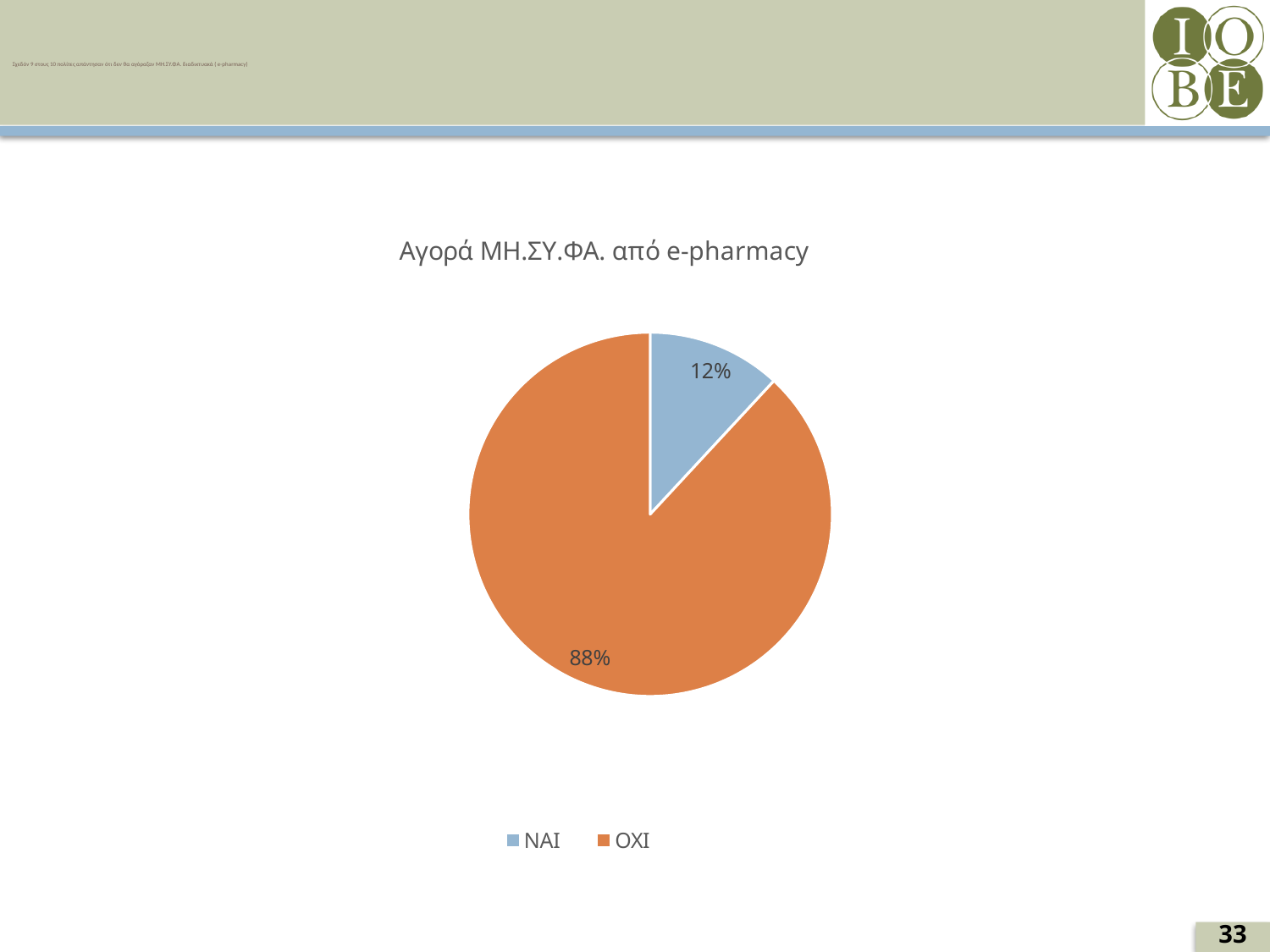
What is the title of the chart? Αγορά ΜΗ.ΣΥ.ΦΑ. από e-pharmacy What is the difference in percentage points between the ΟΧΙ and ΝΑΙ slices? 76 Which slice is the smallest? ΝΑΙ How many entries does the legend list? 2 How many slices does the pie chart have? 2 What share of the pie does ΝΑΙ represent? 12% What share of the pie does ΟΧΙ represent? 88% What kind of chart is shown on the slide? pie chart Which slice is the largest? ΟΧΙ What colour is the ΟΧΙ slice? orange Which is larger, the ΝΑΙ slice or the ΟΧΙ slice? ΟΧΙ